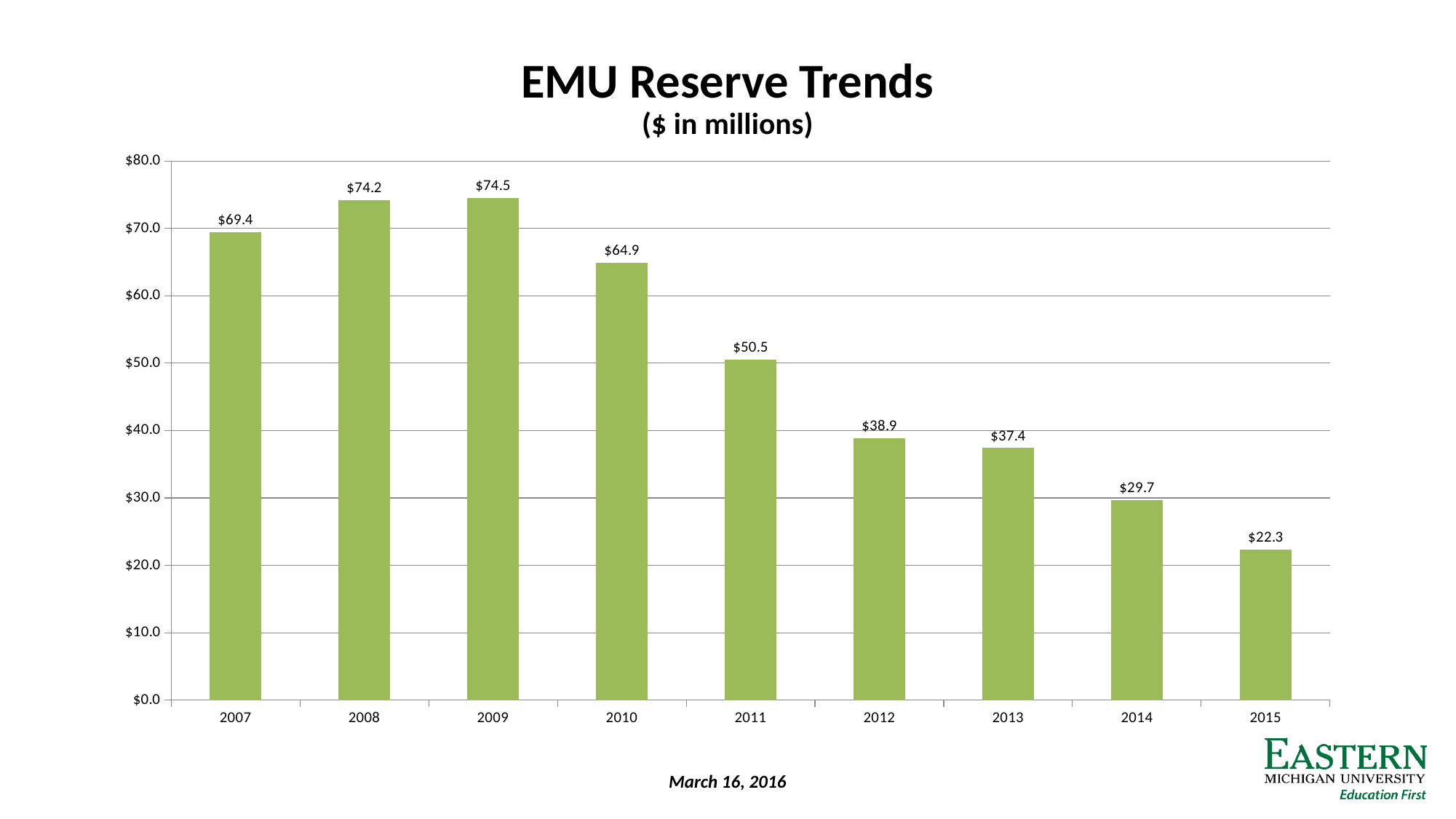
What is the reserve value for 2012? $38.9 Do the reserve values generally rise or fall from 2009 to 2015? Fall What is the reserve value for 2010? $64.9 What is the difference between the reserve values for 2007 and 2015? $47.1 Which year has a larger reserve value, 2013 or 2014? 2013 What is the difference between the reserve values for 2010 and 2011? $14.4 Which year has the lowest reserve value? 2015 Is the value for 2011 greater or less than $60.0? less What kind of chart is shown on the slide? Bar chart Which year has the highest reserve value? 2009 How many years are shown on the chart? 9 What is the reserve value for 2015? $22.3